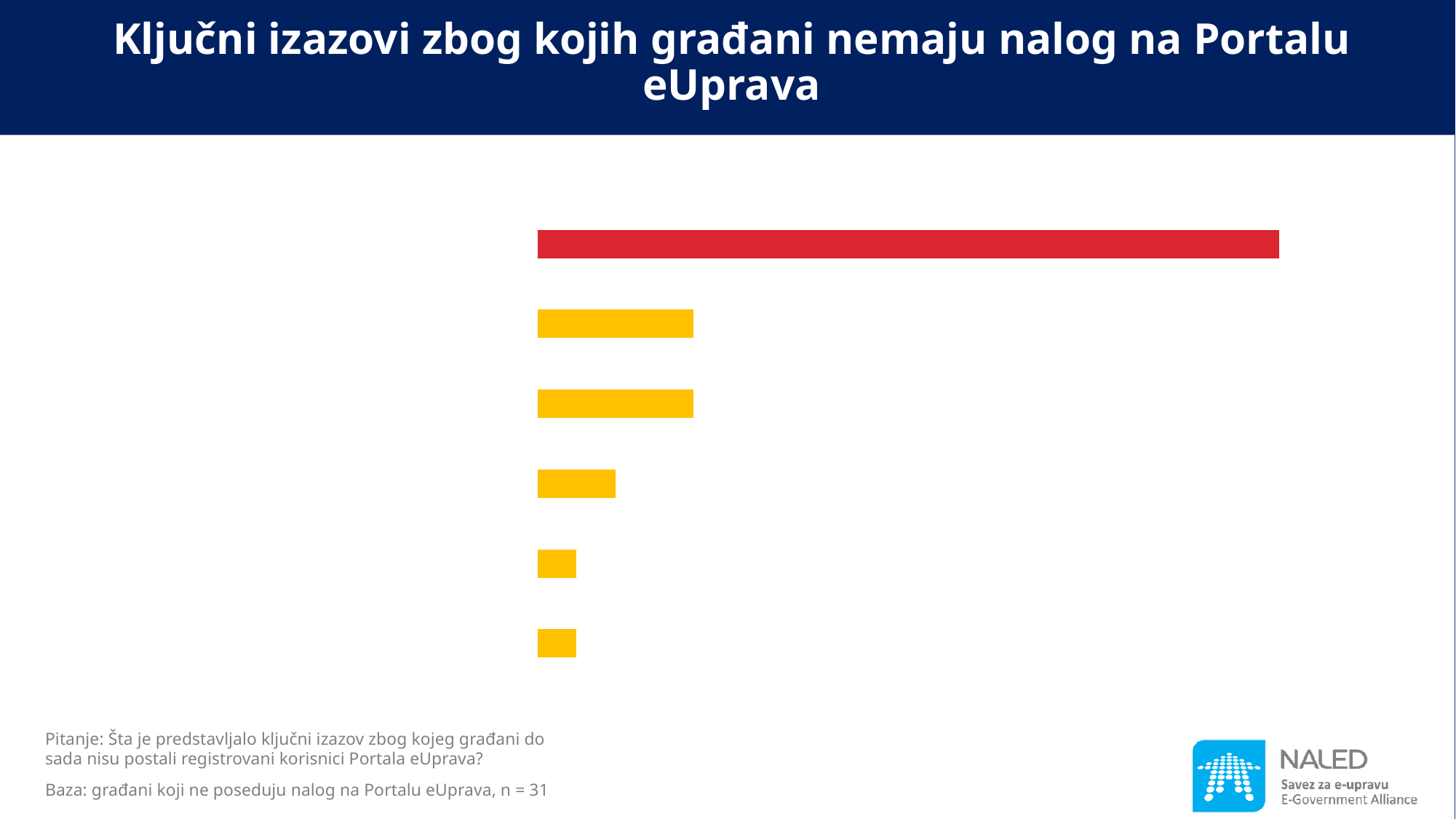
Do the bar lengths increase or decrease going from the top bar to the bottom bar? decrease Which bar is the longest: the top bar or the bottom bar? the top bar Which bar in the chart is the longest, by position? the top bar Is the fourth bar from the top longer or shorter than the third bar from the top? shorter What kind of chart is shown on the slide? bar chart How many bars does the chart contain? 6 What colour is the longest bar in the chart? red Is the second bar from the top longer or shorter than the top bar? shorter What is the title of the slide containing the chart? Ključni izazovi zbog kojih građani nemaju nalog na Portalu eUprava